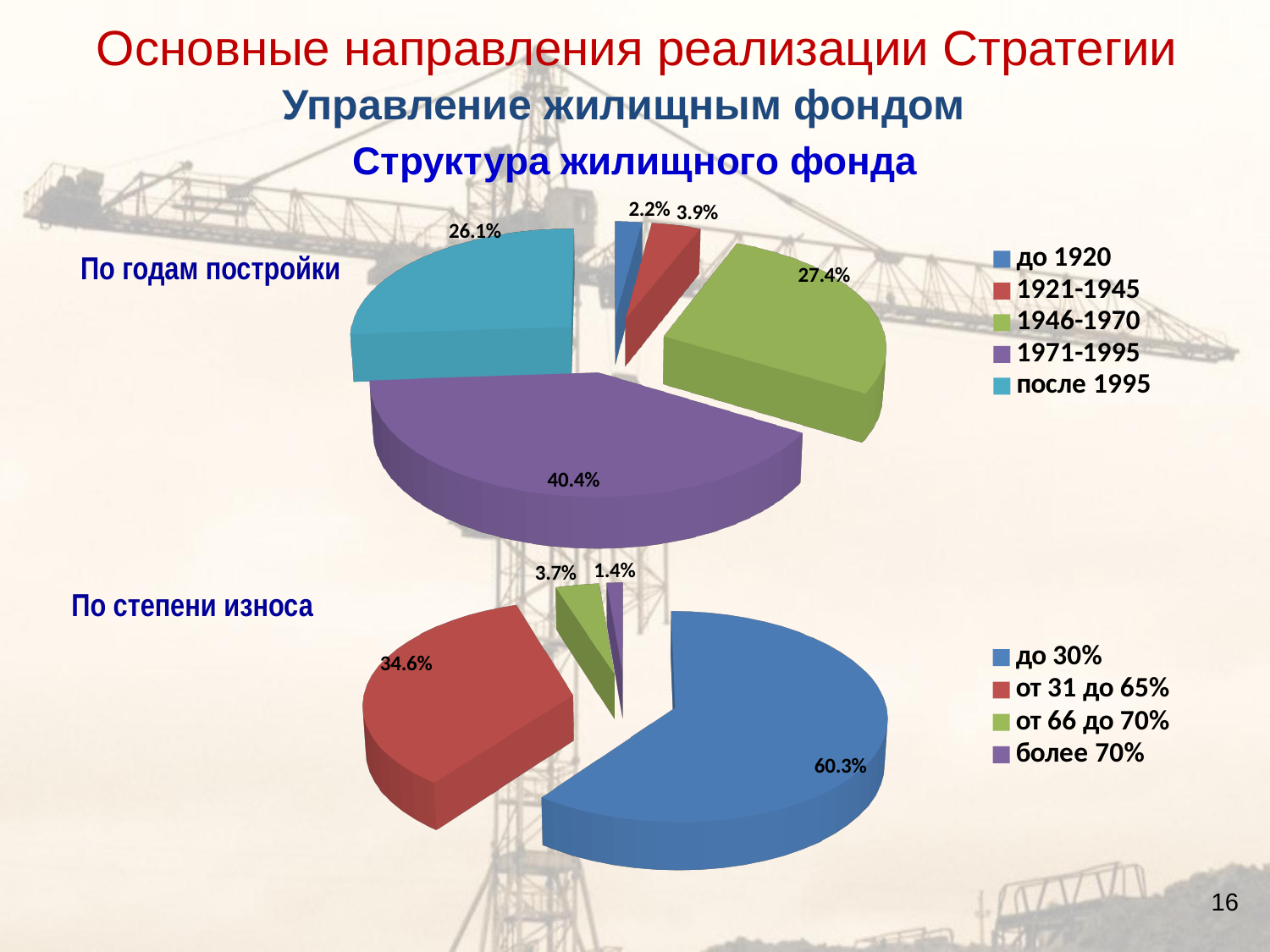
In the bottom pie chart (По степени износа), what share is labelled for the до 30% slice? 60.3% In the top pie chart (По годам постройки), which category has the smallest share? до 1920 In the top pie chart (По годам постройки), what share is labelled for the после 1995 slice? 26.1% What type of chart is used for the bottom chart (По степени износа)? Pie chart In the bottom pie chart (По степени износа), what is the difference between the до 30% share and the от 31 до 65% share? 25.7% In the bottom pie chart (По степени износа), which category has the smallest share? более 70% In the bottom pie chart (По степени износа), which is larger: the share for от 31 до 65% or the share for до 30%? до 30% In the top pie chart (По годам постройки), which category has the largest share? 1971-1995 In the top pie chart (По годам постройки), what share is labelled for the 1971-1995 slice? 40.4% In the top pie chart (По годам постройки), what is the difference between the 1946-1970 share and the 1921-1945 share? 23.5% How many categories does the legend of the top pie chart (По годам постройки) list? 5 In the bottom pie chart (По степени износа), what share is labelled for the от 66 до 70% slice? 3.7%